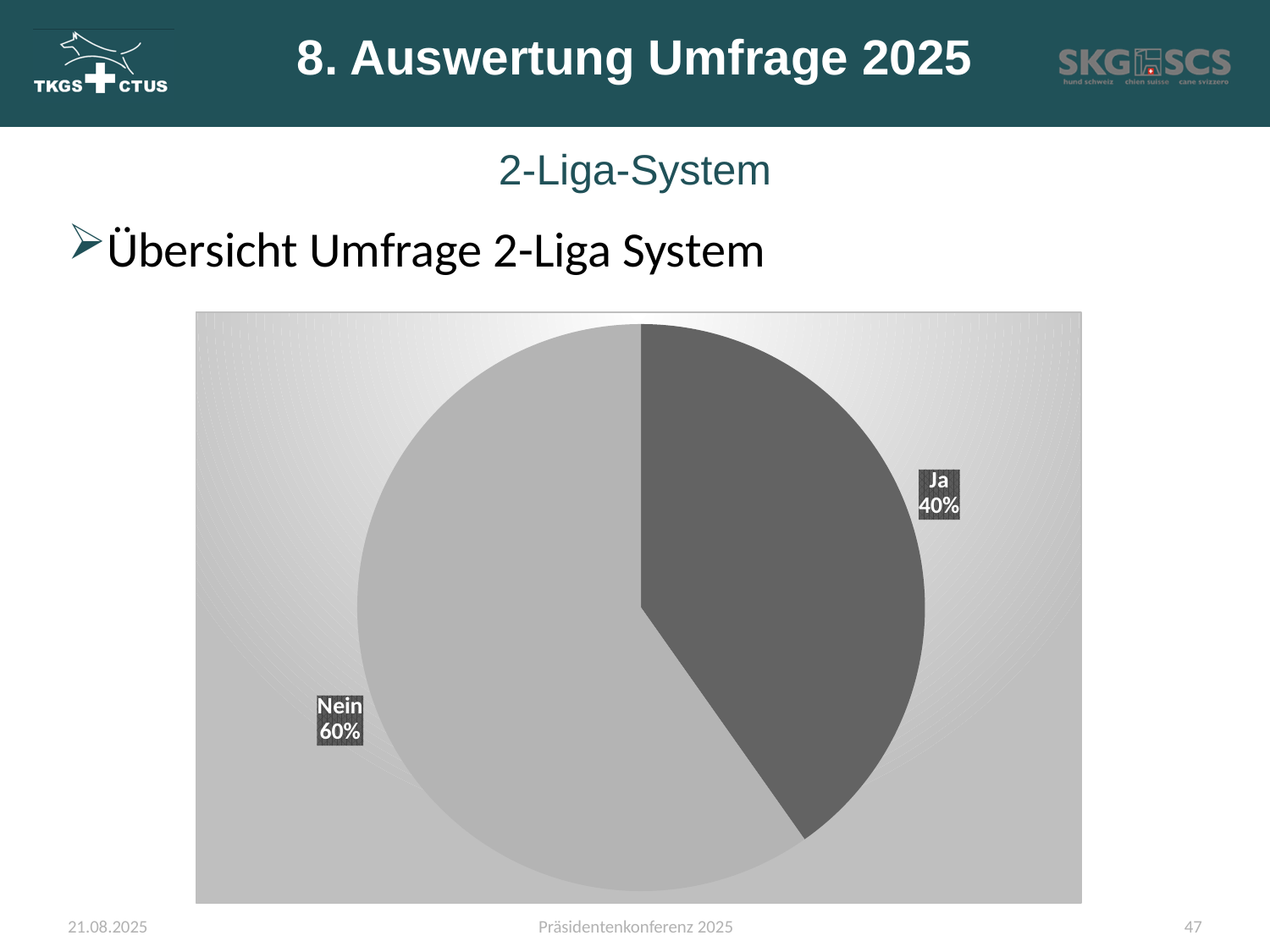
Which is larger, the "Ja" slice or the "Nein" slice? Nein Which slice of the pie is the smallest? Ja What share of the pie does the "Ja" slice represent? 40% What kind of chart is shown on the slide? pie chart What share of the pie does the "Nein" slice represent? 60% How many slices does the pie chart have? 2 Is the share for "Ja" greater or less than 50%? less Which slice of the pie is the largest? Nein What is the subtitle above the chart on the slide? 2-Liga-System What is the difference in percentage points between the "Nein" and "Ja" slices? 20 percentage points Which slice of the pie is shown in the darker grey colour? Ja